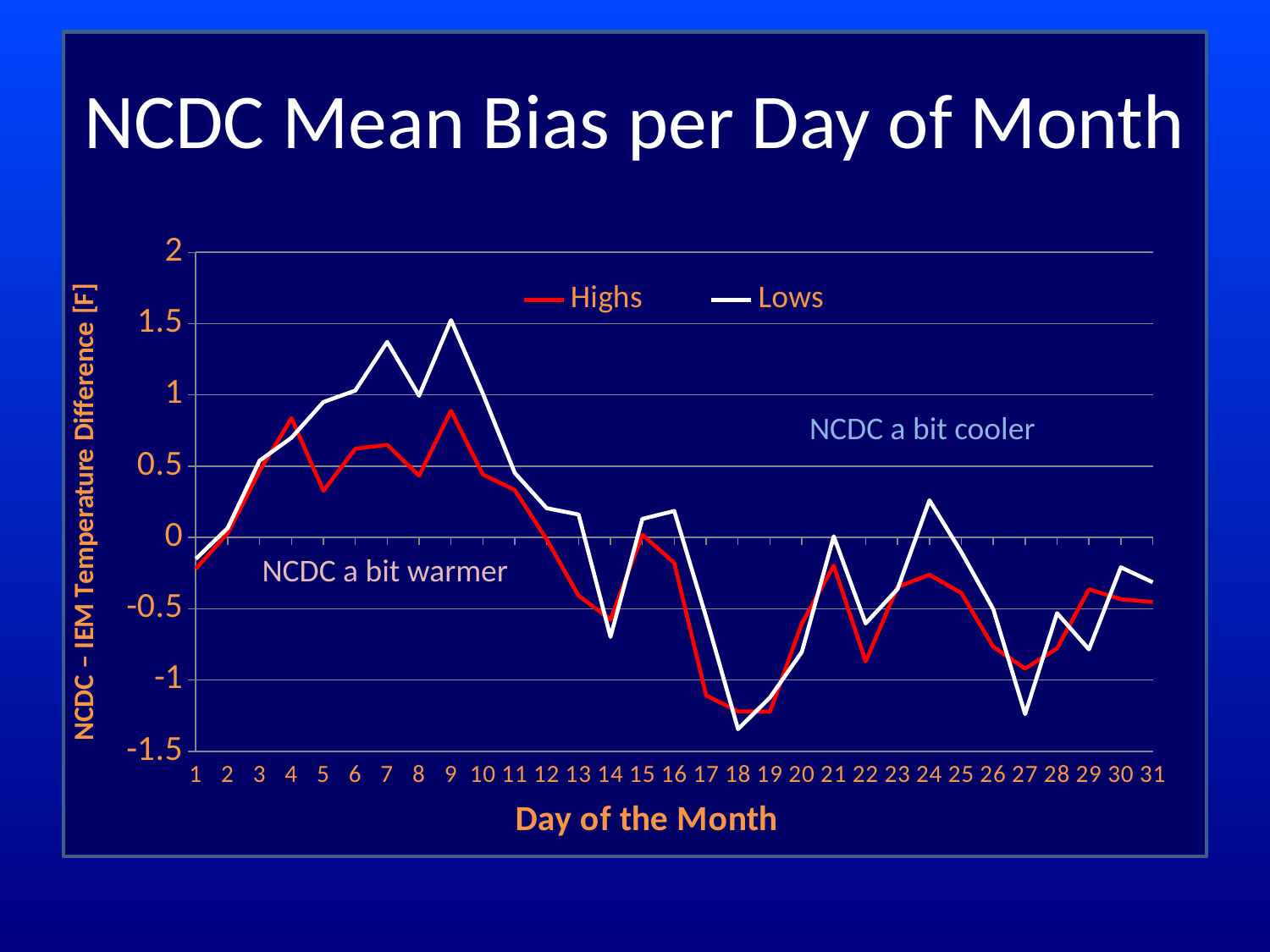
On day 27, which series has the larger value, Highs or Lows? Highs On day 7, which series has the larger value, Highs or Lows? Lows Is the value for Lows on day 27 greater or less than -1? less Is the value for Lows on day 9 greater or less than 1? greater How many series does the legend list? 2 How many days of the month are plotted along the x axis? 31 Is the value for Highs on day 9 greater or less than 0.5? greater On which day of the month does the Lows series reach its highest value? 9 What kind of chart is shown on the slide? line chart What is the label on the y axis? NCDC – IEM Temperature Difference [F] Does the Lows series rise or fall from day 9 to day 18? fall